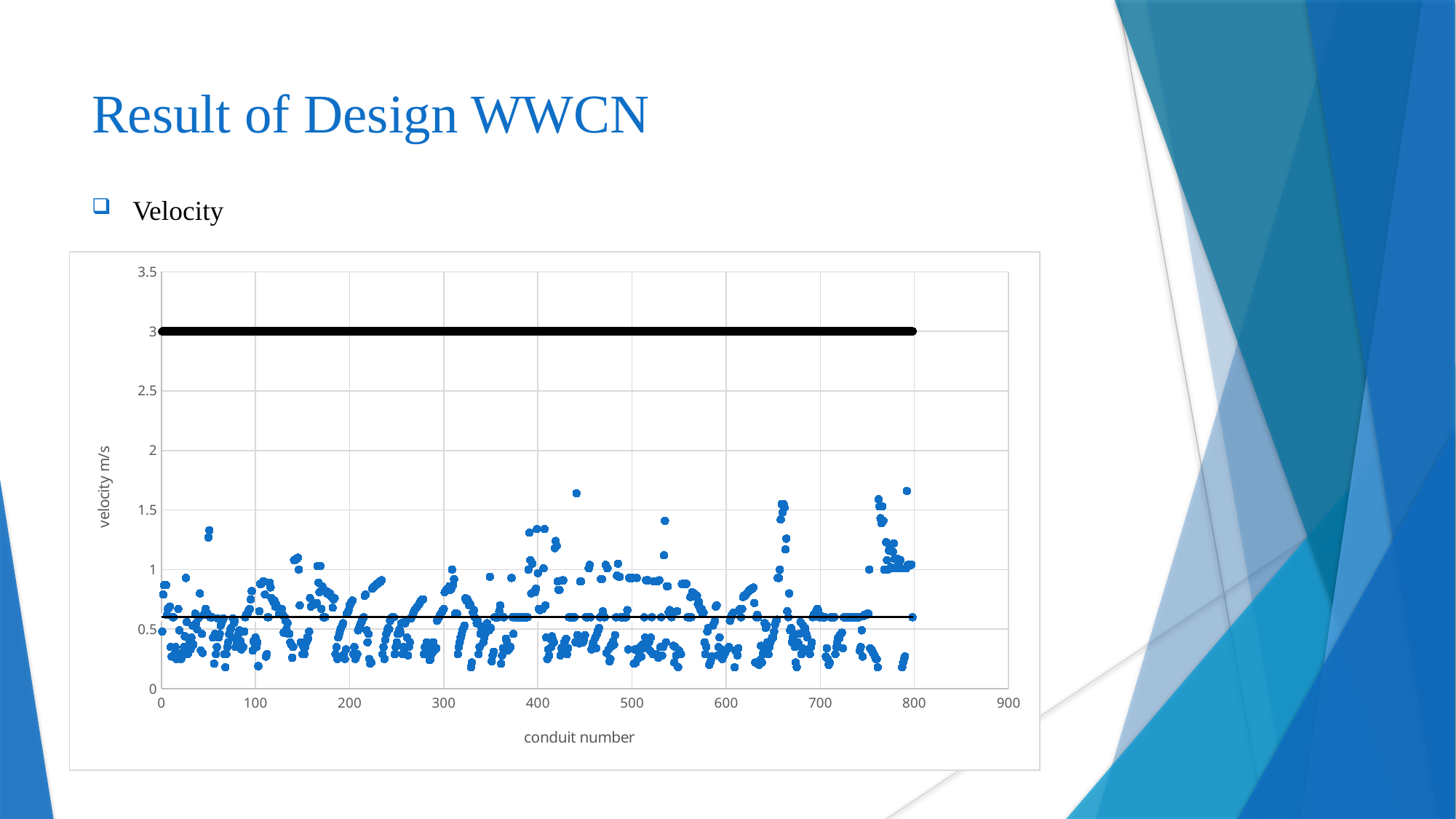
Which is higher on the chart, the thick black line or the thin black line? the thick black line What is the maximum value shown on the vertical axis of the chart? 3.5 Are all the blue data points on the chart greater or less than 3? less What is the label of the horizontal axis of the chart? conduit number What kind of chart is shown on the slide? scatter chart At what velocity value does the thick black horizontal line sit on the chart? 3 Is the lowest blue data point on the chart greater or less than 0.5? less What is the label of the vertical axis of the chart? velocity m/s Is the highest blue data point on the chart greater or less than 2? less